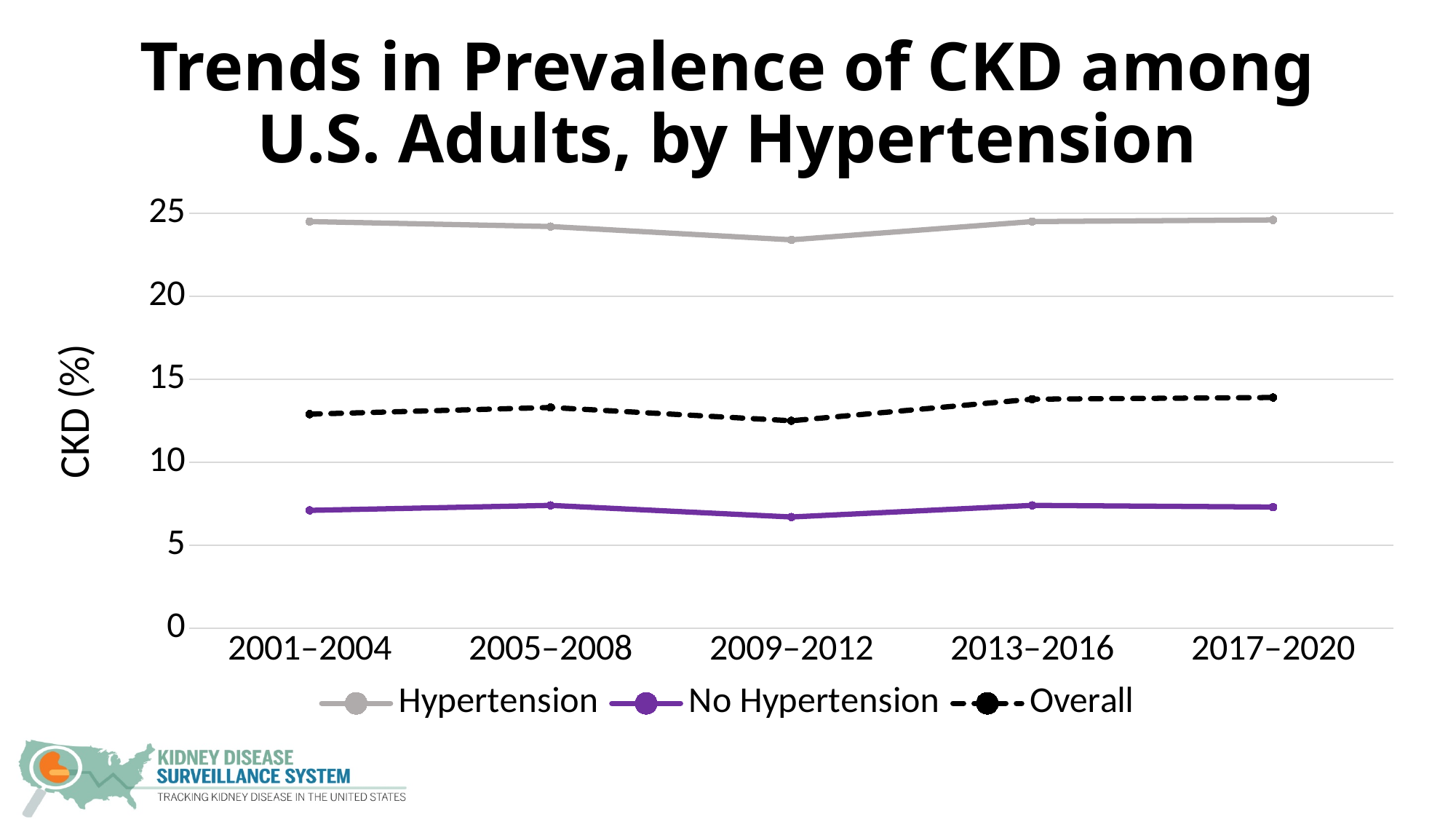
Is the value for Hypertension in 2009–2012 greater or less than 25? less Is the value for No Hypertension in 2017–2020 greater or less than 10? less Is the value for Overall in 2013–2016 greater or less than 15? less What kind of chart is shown on the slide? line chart In which period is the Hypertension series at its lowest? 2009–2012 What is the label of the y axis? CKD (%) In which period is the Overall series at its lowest? 2009–2012 How many time periods are shown on the x axis? 5 Which series has the higher value in 2005–2008, Hypertension or No Hypertension? Hypertension How many series does the legend list? 3